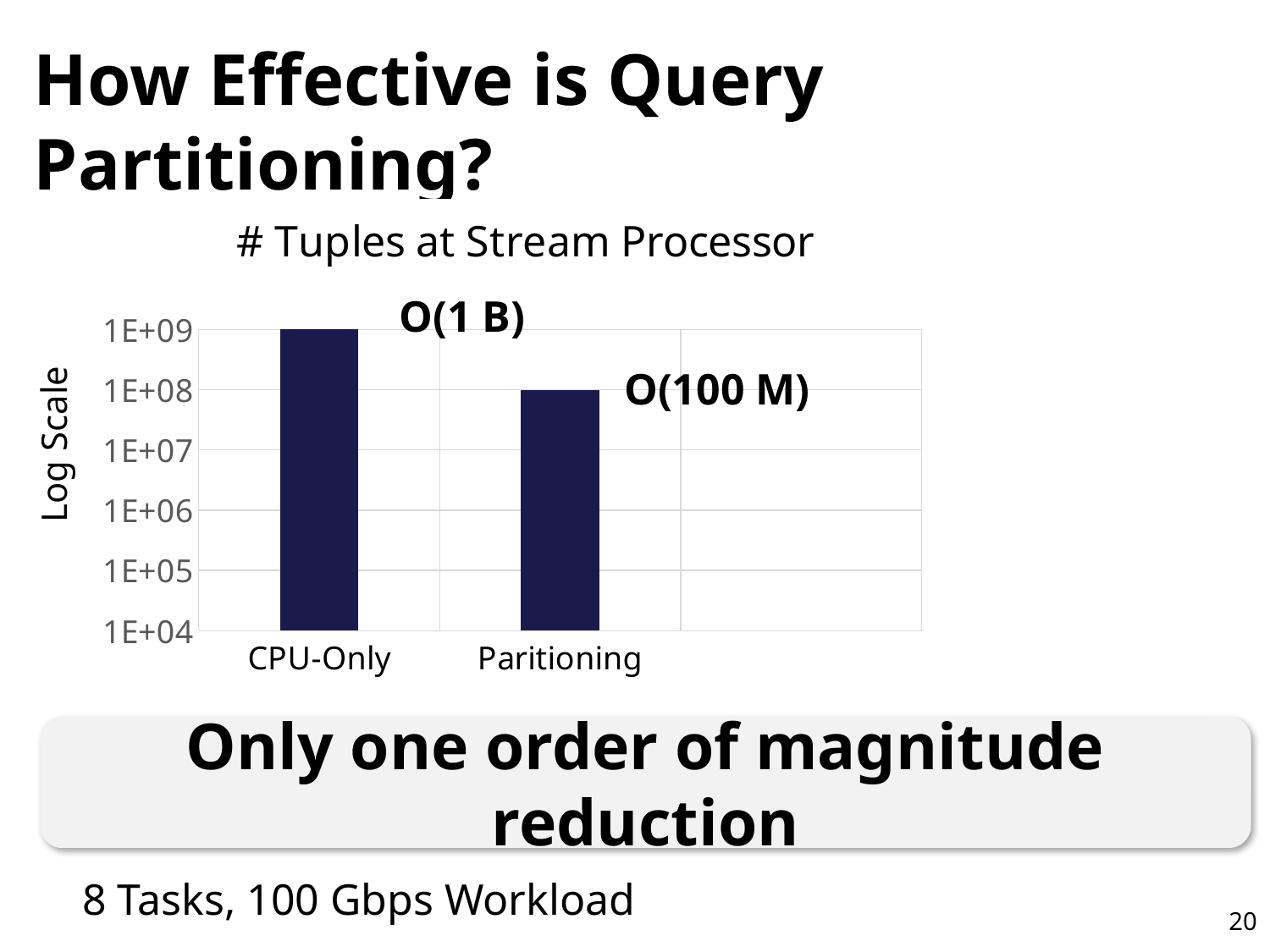
What annotation is printed next to the Paritioning bar? O(100 M) What is the label on the y axis of the chart? Log Scale What is the title of the chart? # Tuples at Stream Processor What kind of chart is shown on the slide? bar chart Which category has the lowest number of tuples at the stream processor? Paritioning How many categories are plotted in the chart? 2 Is the value for Paritioning greater or less than 1E+07? greater What annotation is printed next to the CPU-Only bar? O(1 B) Which is larger, the value for CPU-Only or the value for Paritioning? CPU-Only Which axis tick does the CPU-Only bar reach? 1E+09 Which category has the highest number of tuples at the stream processor? CPU-Only Which axis tick does the Paritioning bar reach? 1E+08